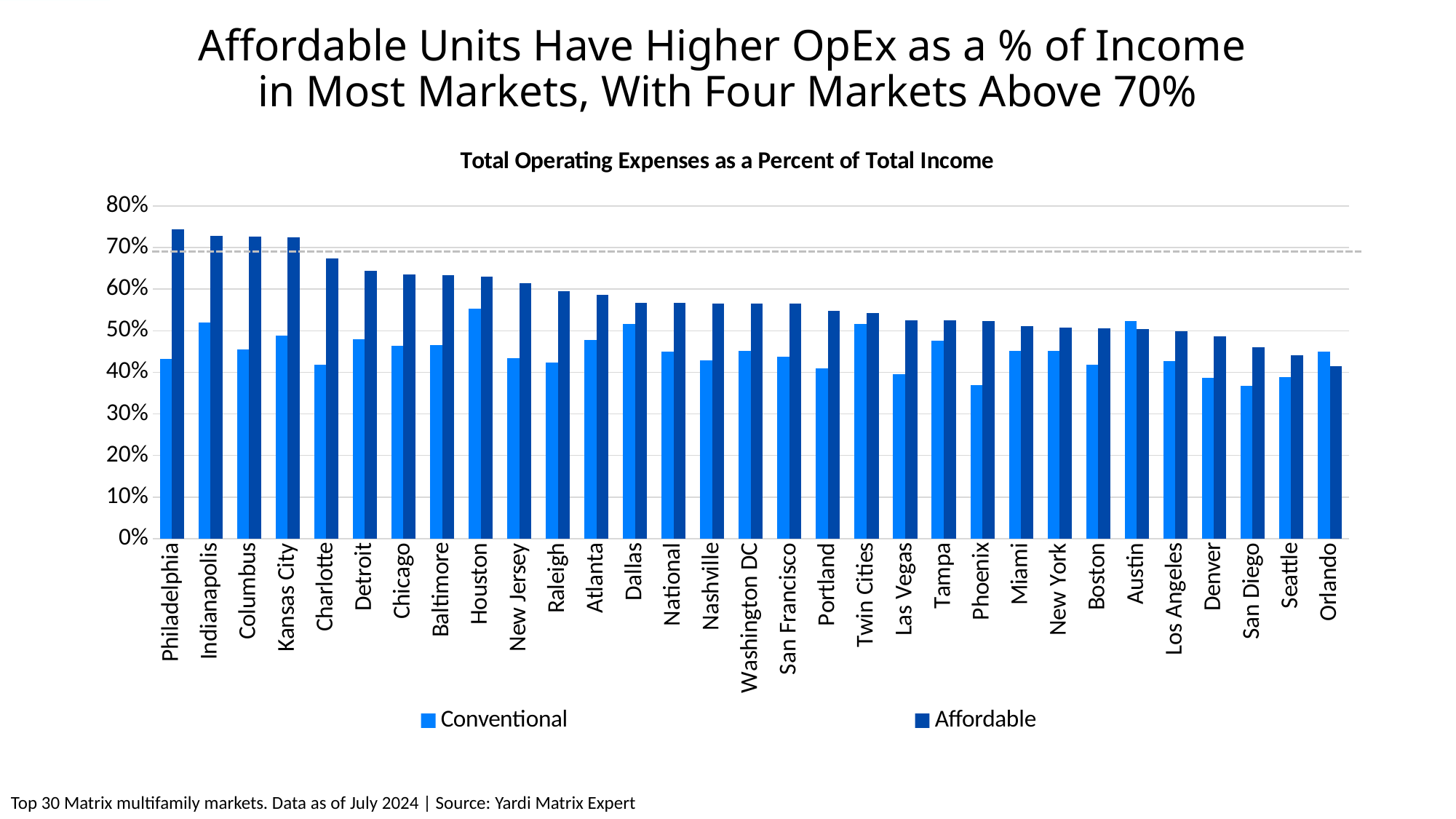
What kind of chart is shown on the slide? Bar chart Which market has the lowest Affordable value? Orlando Is the Affordable value for Philadelphia greater or less than 70%? greater Is the Conventional value for Houston greater or less than 50%? greater Which market has the highest Affordable value? Philadelphia What is the title printed directly above the chart's plot area? Total Operating Expenses as a Percent of Total Income Do the Affordable values generally rise or fall moving from left to right along the x axis? Fall For Orlando, which is larger, the Conventional value or the Affordable value? Conventional How many series does the legend list? 2 Which market has the highest Conventional value? Houston Is the Affordable value for Charlotte greater or less than 70%? less How many markets (categories) are shown on the x axis? 31